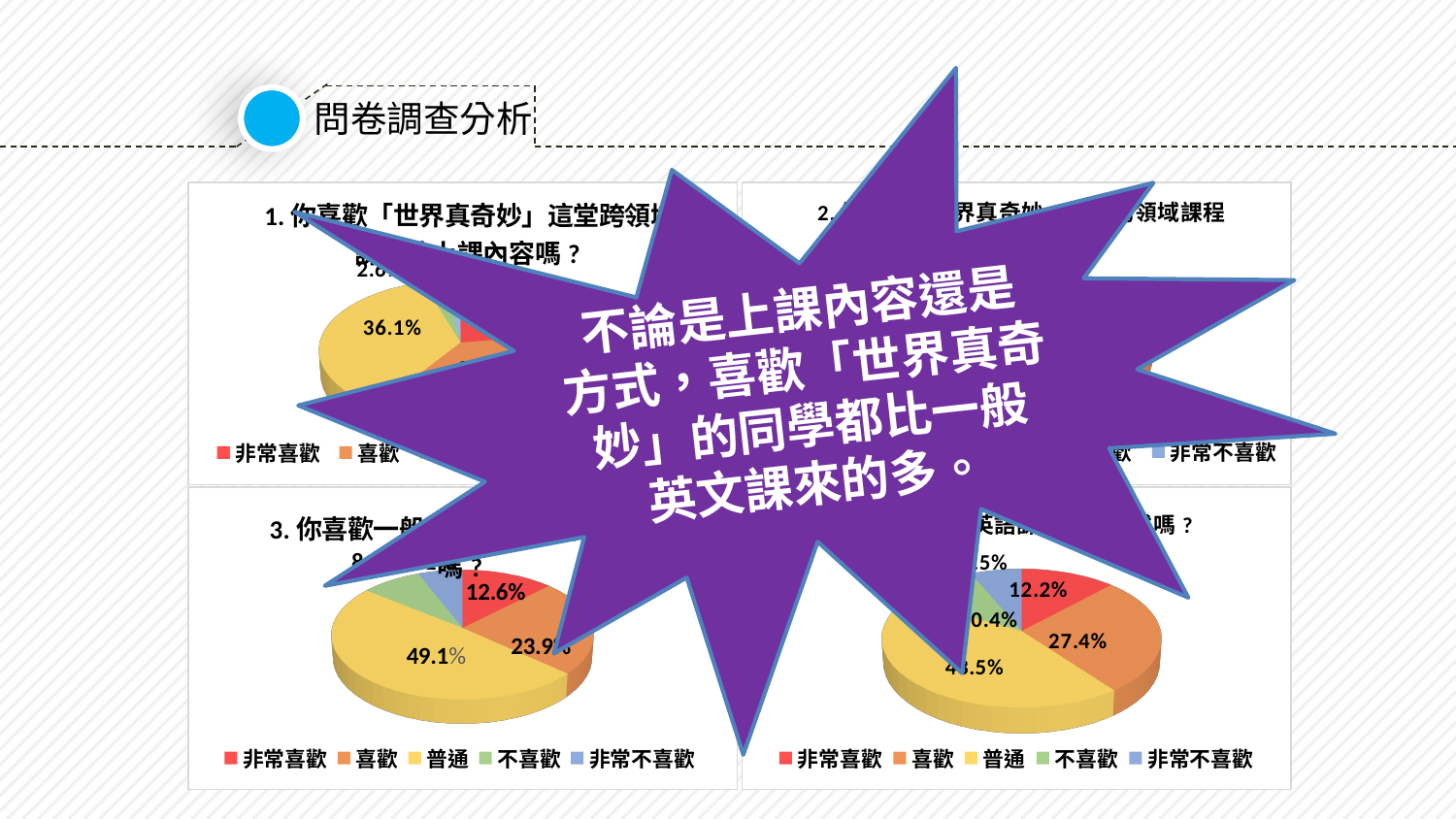
In the bottom-left chart (question 3), what percentage is shown for 非常喜歡? 12.6% In the bottom-left chart (question 3), which is larger: 普通 or 非常喜歡? 普通 Which legend entry is shown in red in the bottom-right chart? 非常喜歡 In the bottom-left chart (question 3), what is the difference between the 普通 slice and the 非常喜歡 slice? 36.5% In the bottom-right chart, what percentage is shown for 喜歡? 27.4% In the top-left chart (question 1), what percentage is labelled on the yellow slice? 36.1% In the bottom-left chart (question 3), which category has the largest slice? 普通 In the bottom-left chart (question 3), what percentage is shown for 普通? 49.1% What kind of chart is the bottom-left chart (question 3)? pie chart In the bottom-right chart, what is the difference between the 喜歡 slice and the 非常喜歡 slice? 15.2% In the bottom-right chart, what percentage is shown for 非常喜歡? 12.2% How many entries does the legend of the bottom-left chart (question 3) list? 5